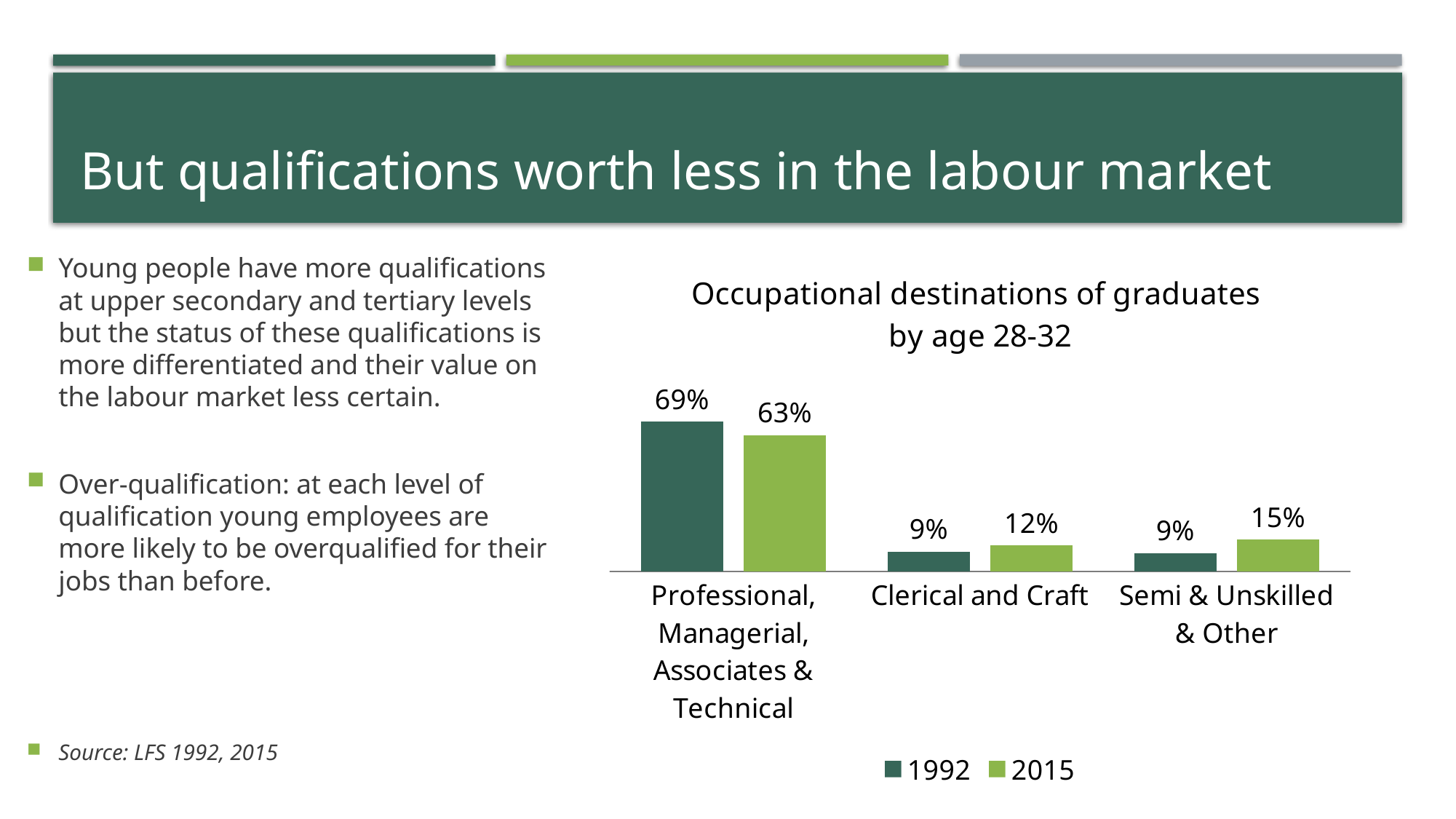
What is the difference between the 1992 and 2015 values for Professional, Managerial, Associates & Technical? 6% What is the 2015 value for Clerical and Craft? 12% What kind of chart is shown on the slide? Bar chart Which category has the lowest value in the 2015 series? Clerical and Craft What is the difference between the 2015 and 1992 values for Semi & Unskilled & Other? 6% What is the 2015 value for Semi & Unskilled & Other? 15% How many categories are shown on the x axis? 3 How many series does the legend list? 2 Which category has the highest value in the 2015 series? Professional, Managerial, Associates & Technical What is the 1992 value for Professional, Managerial, Associates & Technical? 69% Which is larger for Clerical and Craft: the 1992 value or the 2015 value? 2015 What is the title of the chart? Occupational destinations of graduates by age 28-32